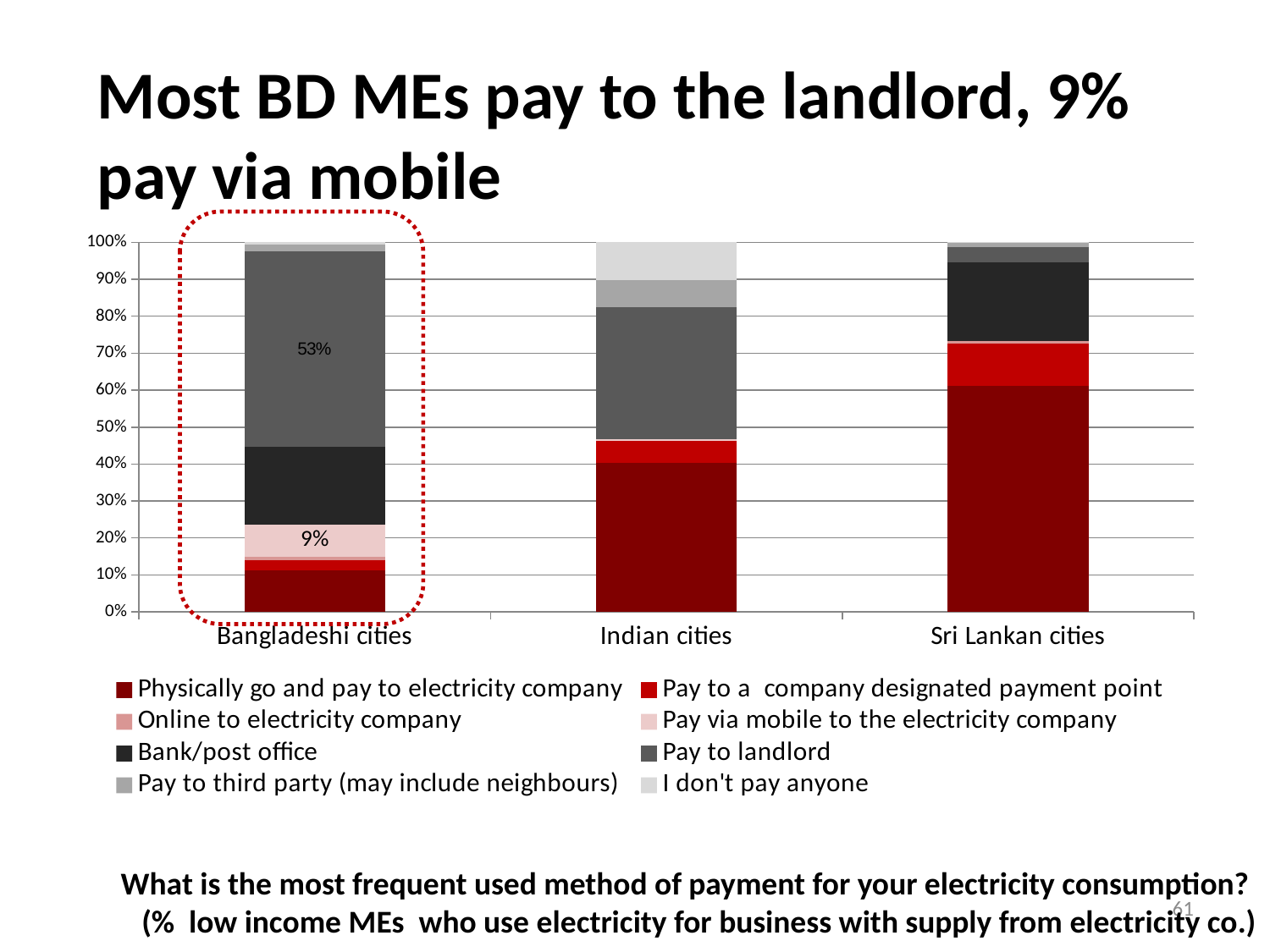
How many payment methods (series) does the legend list? 8 Which city group has the largest share of MEs who pay to the landlord? Bangladeshi cities How many city groups (categories) are shown on the x axis? 3 Which city group has the largest share of MEs who don't pay anyone? Indian cities Which is larger: the 'Physically go and pay to electricity company' share for Sri Lankan cities or for Indian cities? Sri Lankan cities Is the share of Sri Lankan cities MEs who physically go and pay to the electricity company greater or less than 50%? greater What kind of chart is shown on the slide? Stacked bar chart What percentage of Bangladeshi cities MEs pay via mobile to the electricity company? 9% What is the title of the slide? Most BD MEs pay to the landlord, 9% pay via mobile Which city group has the largest share of MEs who physically go and pay to the electricity company? Sri Lankan cities What percentage of Bangladeshi cities MEs pay to the landlord? 53% Is the share of Bangladeshi cities MEs who physically go and pay to the electricity company greater or less than 20%? less